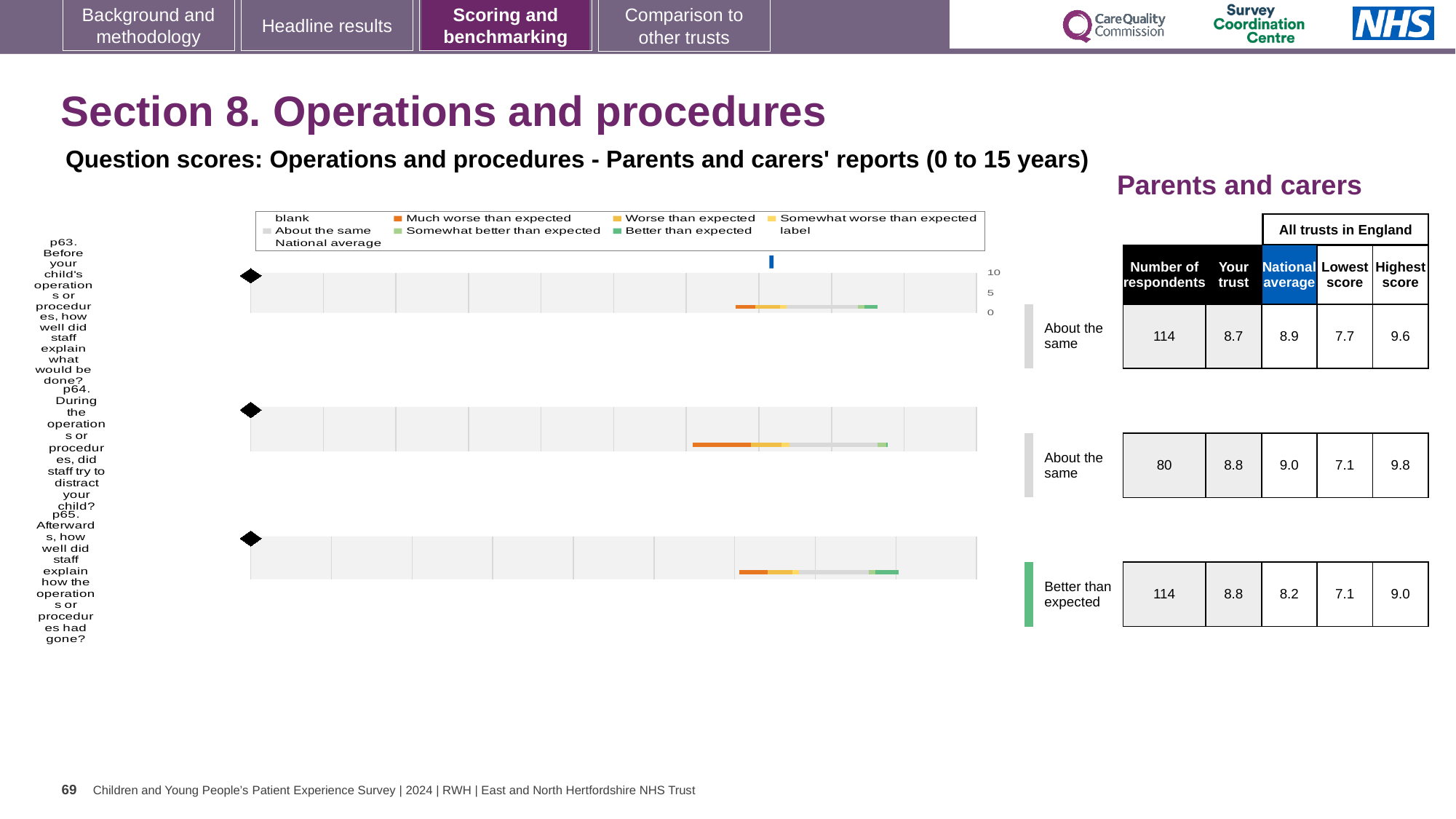
How many respondents answered p64? 80 What is the national average score for p63 (Before your child's operations or procedures, how well did staff explain what would be done?)? 8.9 What kind of chart is used to show the question scores? bar chart Which question has the lowest 'Your trust' score? p63 What benchmark category is shown for p65 (Afterwards, how well did staff explain how the operations or procedures had gone?)? Better than expected What is the highest score among all trusts in England for p64? 9.8 What is the difference between the trust score and the national average for p65? 0.6 For p63, which is larger: the trust score or the national average? National average Which question has the highest national average score? p64 What is the 'Your trust' score for p64 (During the operations or procedures, did staff try to distract your child?)? 8.8 How many survey questions are plotted in the chart? 3 In the legend, what colour represents 'Much worse than expected'? Orange